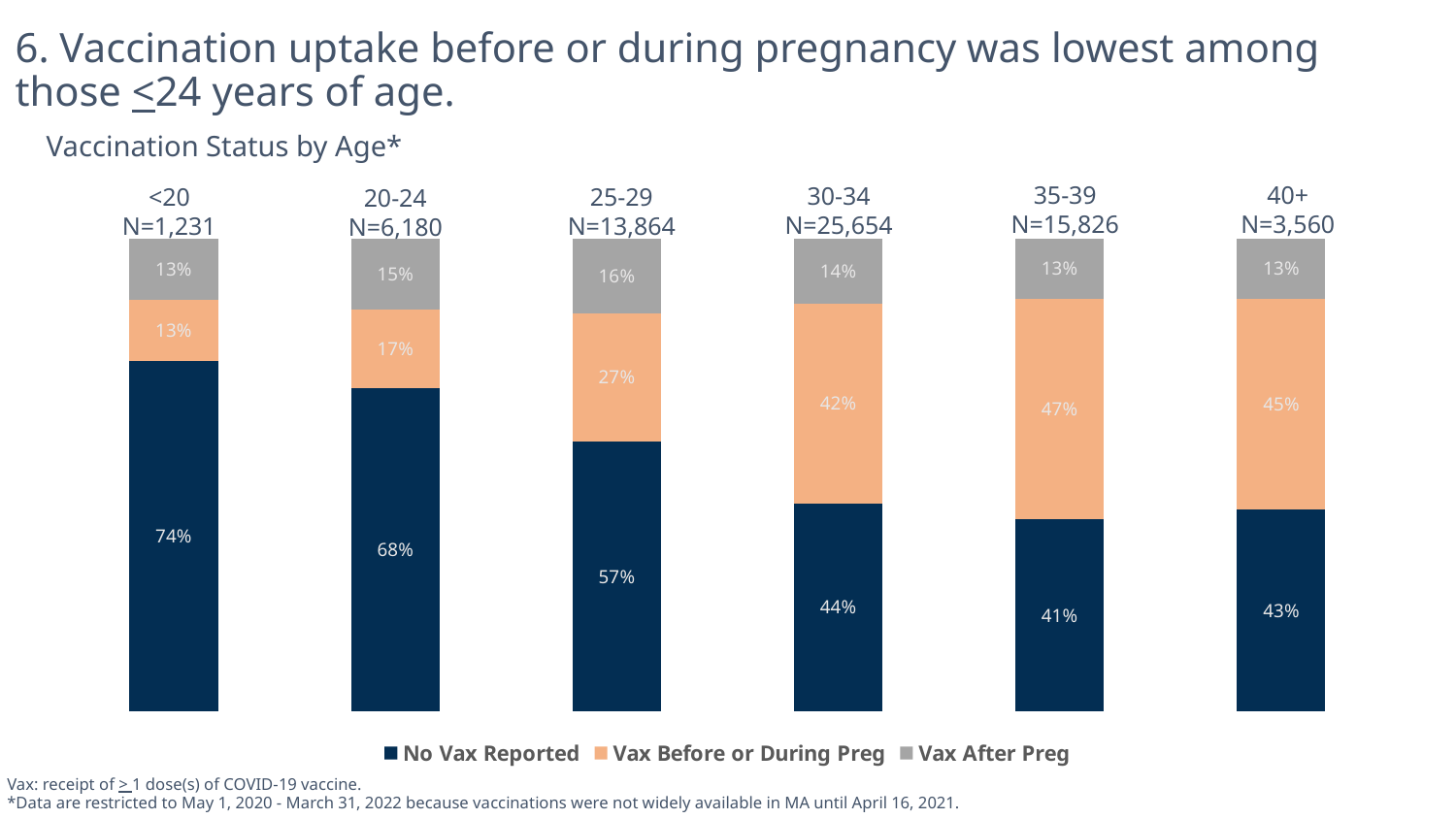
What is the sample size (N) for the 30-34 age group? N=25,654 Which is larger: Vax Before or During Preg for 40+ or for 30-34? 40+ How many age groups are shown in the chart? 6 What percentage of the <20 age group had No Vax Reported? 74% Which colour represents Vax After Preg in the legend? Gray What kind of chart is shown on the slide? Stacked bar chart What percentage of the 25-29 age group had Vax After Preg? 16% Which age group has the highest percentage of Vax Before or During Preg? 35-39 Which age group has the lowest percentage of No Vax Reported? 35-39 What is the difference in No Vax Reported between the <20 and 20-24 age groups? 6% How many series does the legend list? 3 What percentage of the 30-34 age group had Vax Before or During Preg? 42%